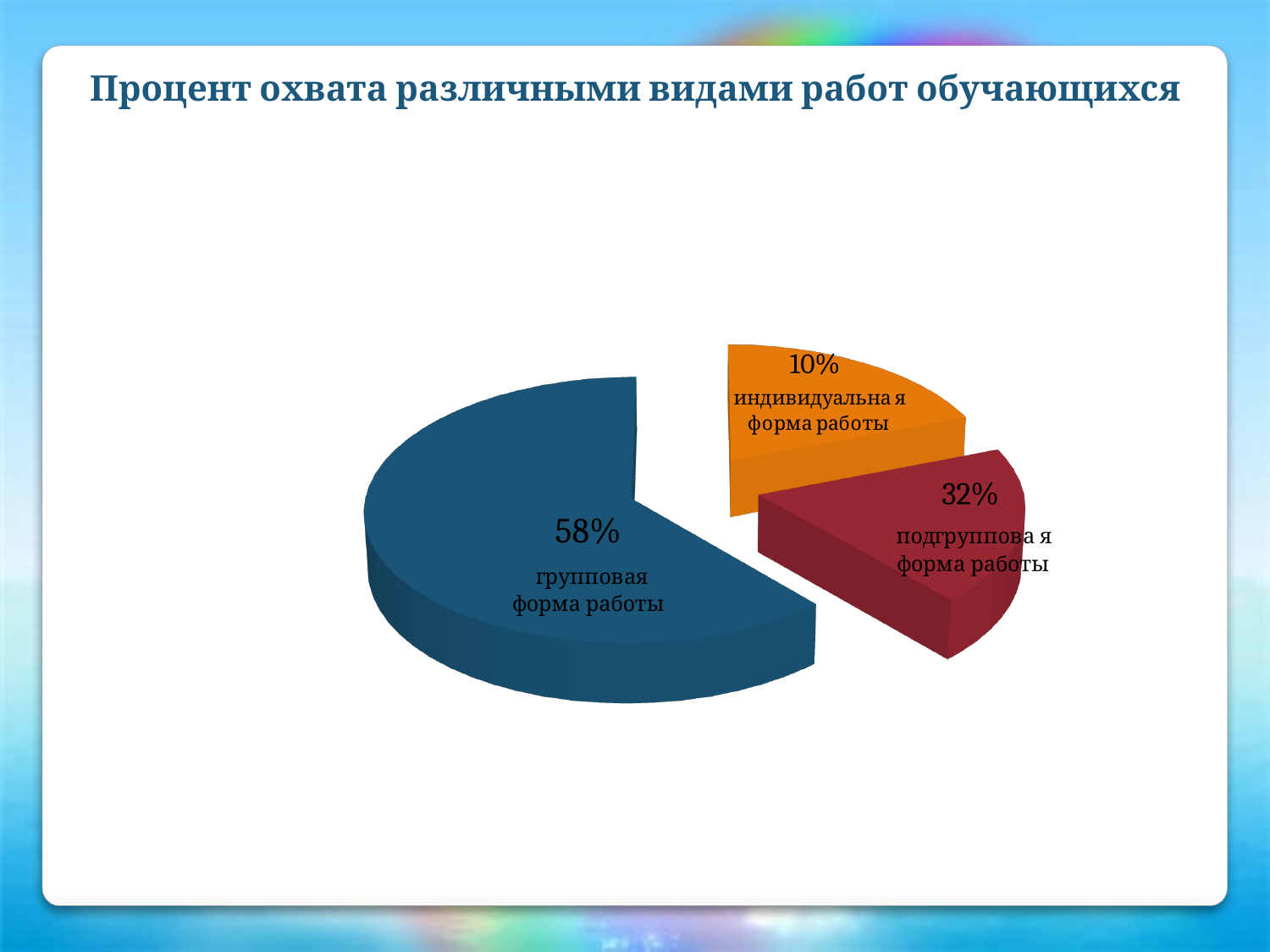
Which is larger: the share for подгрупповая форма работы or индивидуальная форма работы? подгрупповая форма работы What percentage is shown for индивидуальная форма работы? 10% Which form of work has the largest share of the pie? групповая форма работы How many slices does the pie chart have? 3 What is the title of the slide? Процент охвата различными видами работ обучающихся What is the difference in percentage points between групповая форма работы and подгрупповая форма работы? 26 What percentage is shown for групповая форма работы? 58% What percentage is shown for подгрупповая форма работы? 32% What colour is the slice for групповая форма работы? blue Which form of work has the smallest share of the pie? индивидуальная форма работы What kind of chart is shown on the slide? pie chart What is the difference in percentage points between подгрупповая форма работы and индивидуальная форма работы? 22